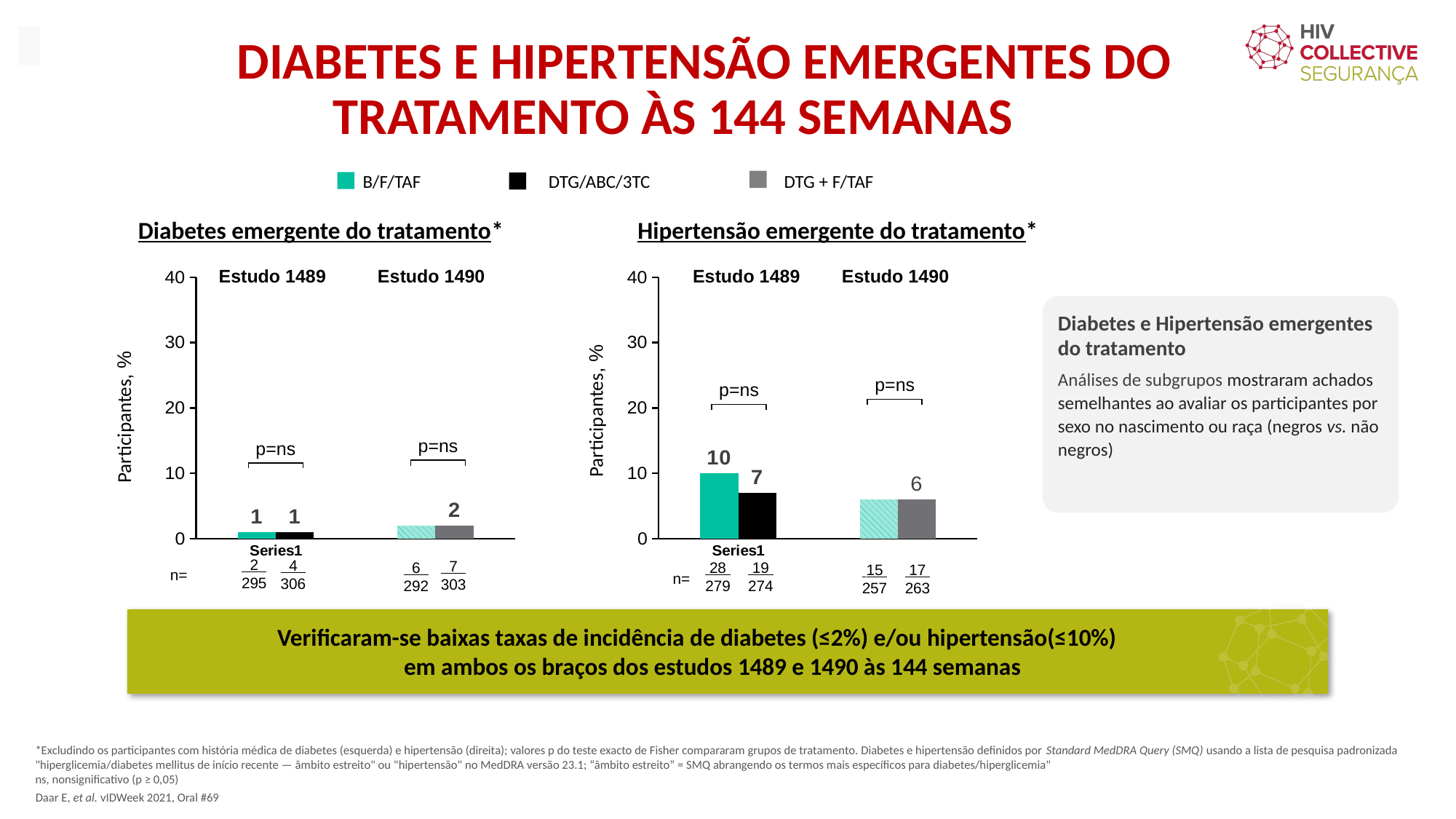
In the 'Hipertensão emergente do tratamento' chart, what is the value for DTG/ABC/3TC in Estudo 1489? 7 In the 'Hipertensão emergente do tratamento' chart, which is larger in Estudo 1489: B/F/TAF or DTG/ABC/3TC? B/F/TAF In the 'Hipertensão emergente do tratamento' chart, is the value for B/F/TAF in Estudo 1489 greater or less than 20? less What is the y-axis label of the 'Hipertensão emergente do tratamento' chart? Participantes, % What kind of chart is the 'Diabetes emergente do tratamento' chart? bar chart How many series does the legend list for the charts? 3 In the 'Diabetes emergente do tratamento' chart, what is the value for DTG + F/TAF in Estudo 1490? 2 In the 'Hipertensão emergente do tratamento' chart, which bar has the highest value? B/F/TAF in Estudo 1489 In the 'Hipertensão emergente do tratamento' chart, what is the value for B/F/TAF in Estudo 1489? 10 In the 'Hipertensão emergente do tratamento' chart, what is the value for DTG + F/TAF in Estudo 1490? 6 In the 'Hipertensão emergente do tratamento' chart, what is the difference between B/F/TAF and DTG/ABC/3TC in Estudo 1489? 3 In the 'Diabetes emergente do tratamento' chart, what is the value for B/F/TAF in Estudo 1489? 1